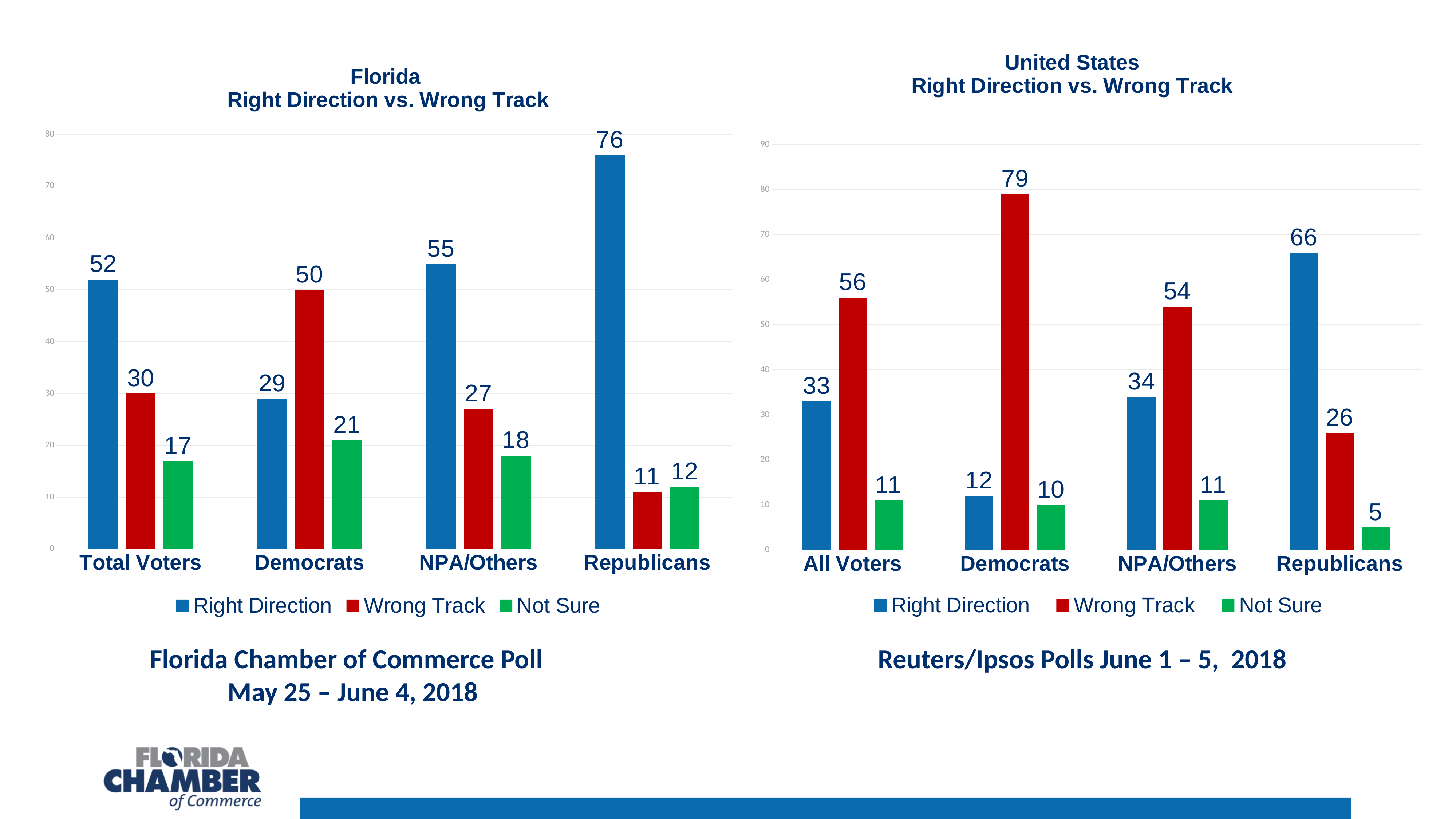
In the Florida chart, what is the difference between the Right Direction values for Republicans and Democrats? 47 In the United States chart, how many series does the legend list? 3 What type of chart is the United States Right Direction vs. Wrong Track chart? Bar chart In the Florida chart, which is larger for NPA/Others: Right Direction or Wrong Track? Right Direction In the United States chart, which category has the lowest Not Sure value? Republicans In the United States chart, what is the difference between the Wrong Track and Right Direction values for All Voters? 23 In the United States Right Direction vs. Wrong Track chart, what is the Wrong Track value for Democrats? 79 In the Florida chart, how many categories are shown on the x axis? 4 In the Florida chart, what is the Not Sure value for Democrats? 21 In the United States chart, which colour represents the Wrong Track series? Red In the Florida Right Direction vs. Wrong Track chart, what is the Right Direction value for Republicans? 76 In the Florida chart, which category has the highest Right Direction value? Republicans